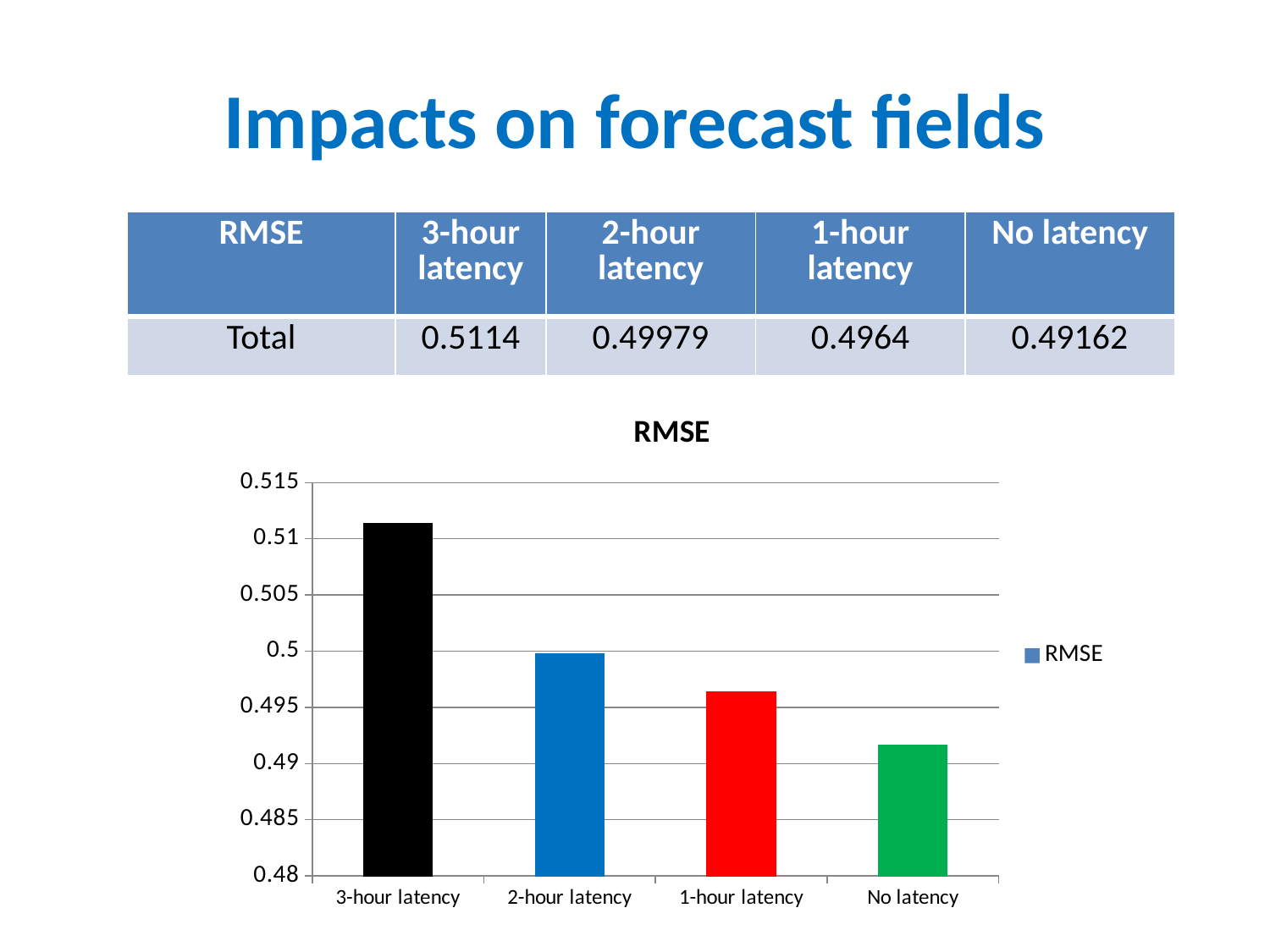
What is the RMSE value for 1-hour latency? 0.4964 Is the RMSE for 2-hour latency greater or less than 0.5? less Is the RMSE for 3-hour latency greater or less than 0.51? greater Which category has the lowest RMSE? No latency What is the RMSE value for 3-hour latency? 0.5114 How many categories are shown on the x axis of the chart? 4 Do the RMSE values rise or fall from 3-hour latency to No latency along the x axis? fall What is the RMSE value for No latency? 0.49162 Which category has the highest RMSE? 3-hour latency How many series does the chart legend list? 1 Which is larger, the RMSE for 2-hour latency or for 1-hour latency? 2-hour latency What type of chart is shown on the slide? bar chart